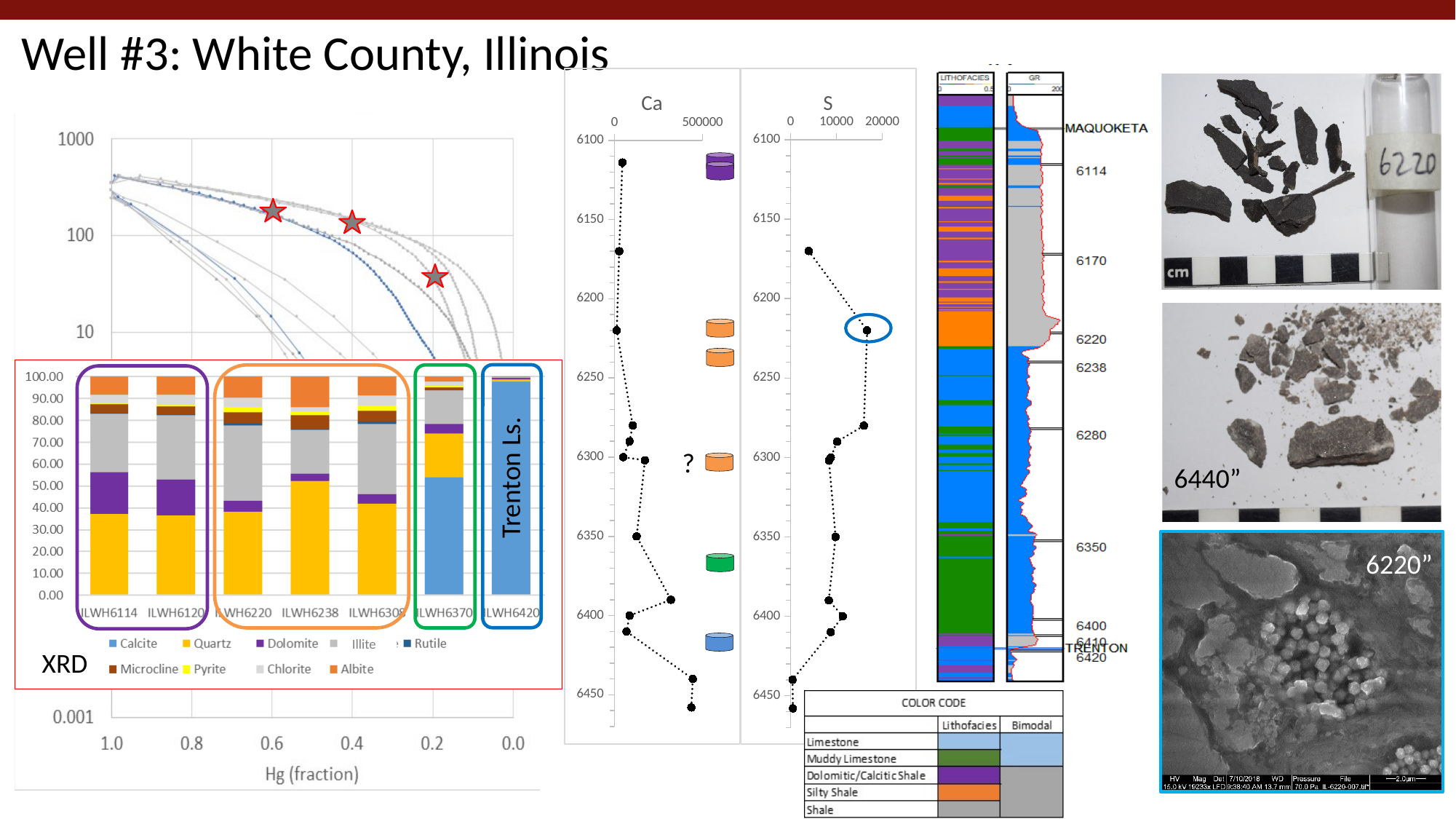
In the XRD stacked bar chart, is the Calcite share for ILWH6420 greater or less than 90? greater In the XRD stacked bar chart, which sample has the largest Calcite share? ILWH6420 How many samples (categories) are shown along the x axis of the XRD stacked bar chart? 7 In the XRD stacked bar chart, which sample has the largest Quartz share? ILWH6238 In the S depth profile chart, is the circled value at about 6220 greater or less than 10000? greater How many minerals does the legend of the XRD stacked bar chart list? 9 In the Ca depth profile chart, is the value at about 6440 greater or less than 500000? less What kind of chart is the XRD chart in the lower left? Stacked bar chart In the XRD stacked bar chart, which colour represents Quartz in the legend? Yellow In the color code table for the lithofacies log, which colour represents Silty Shale? Orange In the XRD stacked bar chart, which sample has a larger Dolomite share, ILWH6114 or ILWH6238? ILWH6114